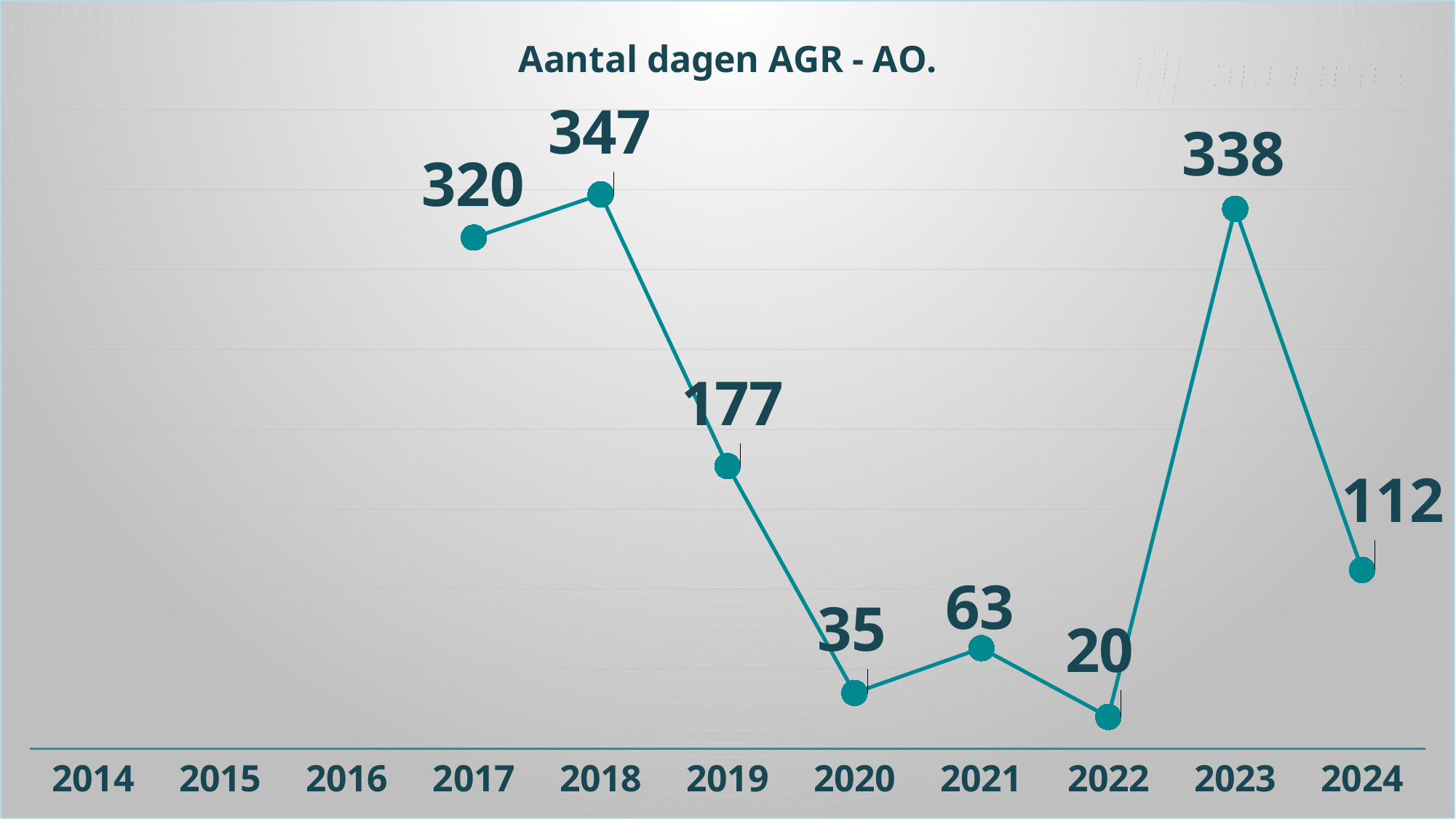
Which is larger, the value for 2020 or the value for 2021? 2021 What is the value for 2022? 20 What is the difference between the values for 2018 and 2019? 170 How many data points are plotted on the line? 8 What is the title of the chart? Aantal dagen AGR - AO. Which year has the lowest value? 2022 What kind of chart is shown? line chart What is the value for 2024? 112 Which is larger, the value for 2017 or the value for 2023? 2023 What is the value for 2018? 347 Which year has the highest value? 2018 What is the difference between the values for 2023 and 2024? 226